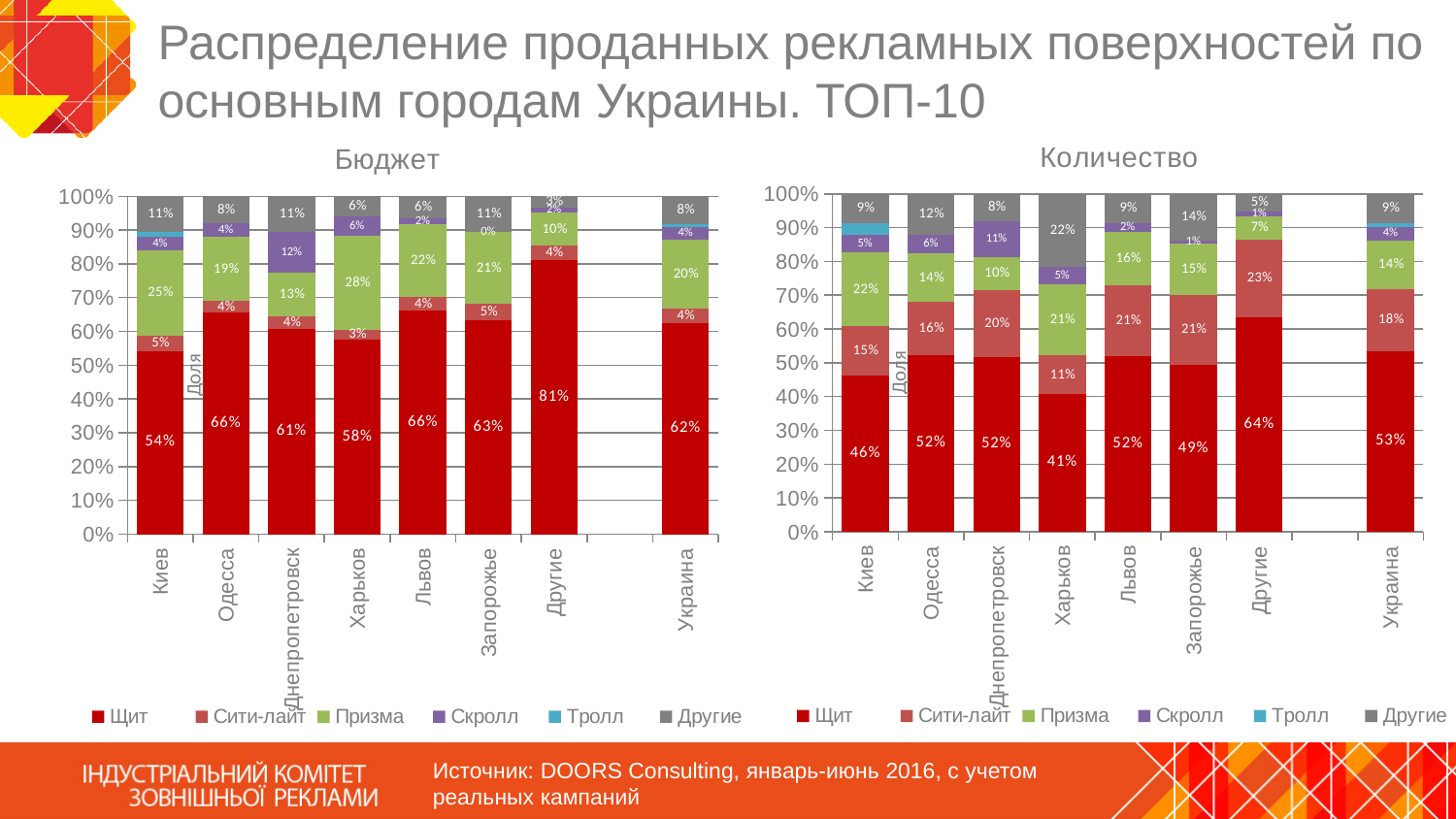
What type of chart is the "Бюджет" chart? Stacked bar chart In the "Количество" chart, which is larger: the Призма value for Киев or for Одесса? Киев In the "Бюджет" chart, what is the difference between the Щит values for Другие and Киев? 27% In the "Количество" chart, what is the Сити-лайт value for Другие? 23% In the "Количество" chart, which category has the lowest Щит share? Харьков How many categories are shown on the x axis of the "Бюджет" chart? 8 In the "Бюджет" chart, what is the value of Щит for Киев? 54% In the "Бюджет" chart, which category has the highest Щит share? Другие How many series does the legend of the "Количество" chart list? 6 In the "Количество" chart, what is the Щит value for Украина? 53% In the "Бюджет" chart, what is the Призма value for Харьков? 28% In the "Количество" chart, what is the value of Щит for Харьков? 41%